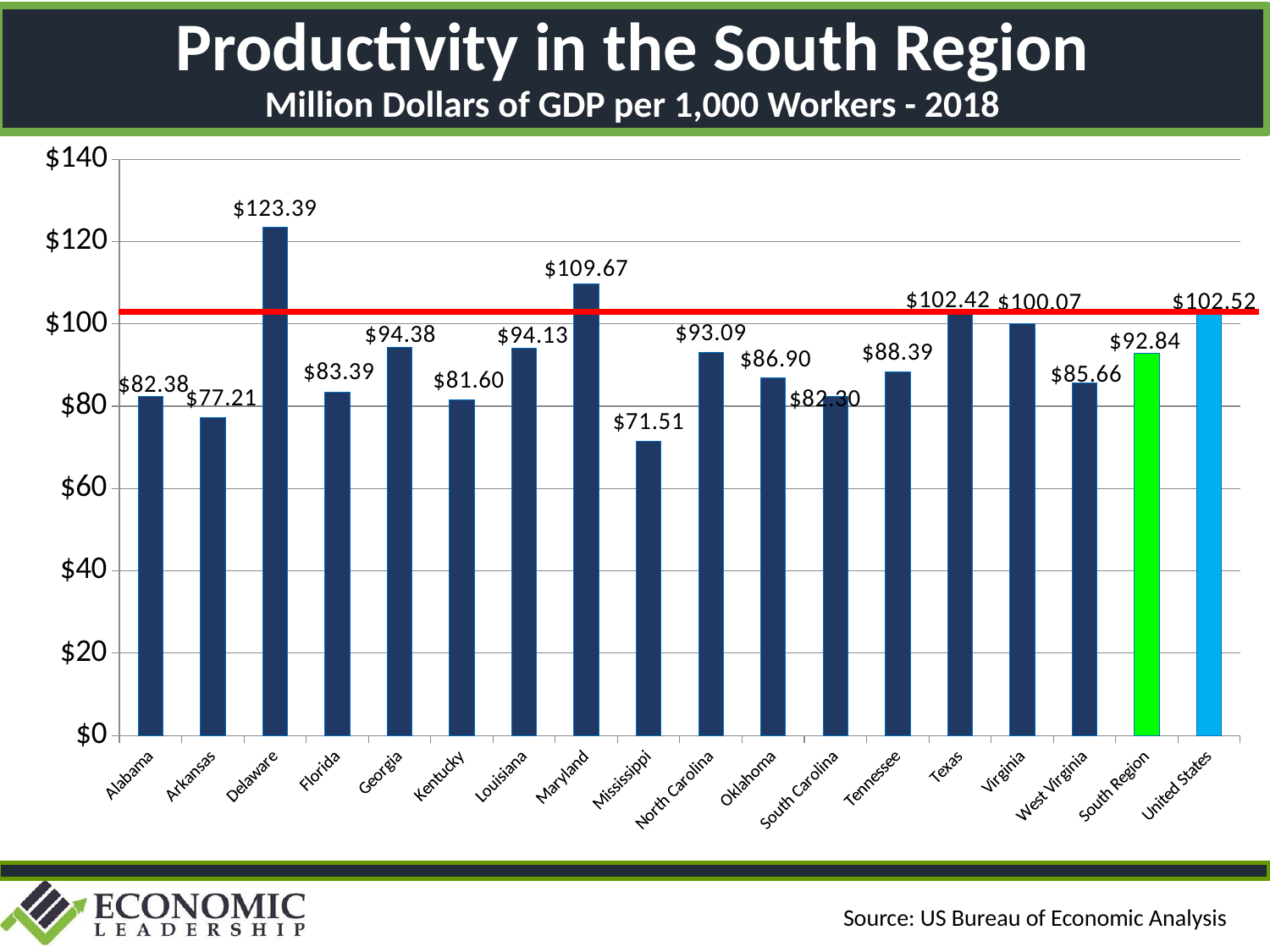
Which category has the highest value? Delaware What is the value for Maryland? $109.67 What is the difference between the values for the United States and the South Region? $9.68 What is the value for Delaware? $123.39 What is the value for the South Region? $92.84 Which category has the lowest value? Mississippi Which is larger, the value for Maryland or the value for Virginia? Maryland How many categories are shown on the x axis? 18 Is the value for Mississippi greater or less than $80? less What kind of chart is shown on the slide? bar chart What is the value for the United States? $102.52 What is the difference between the values for Delaware and Maryland? $13.72